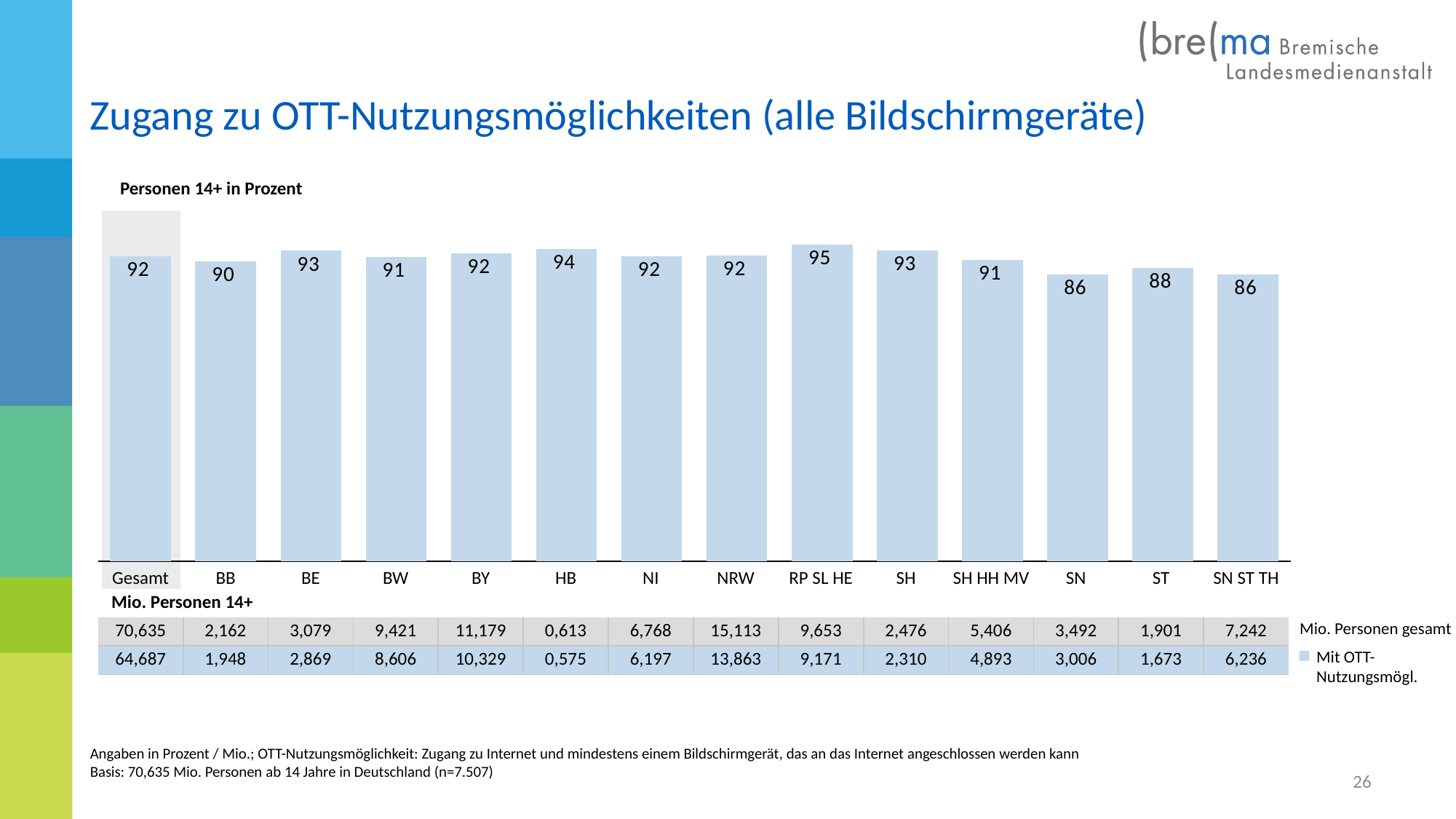
What is the difference between the values for BB and BE? 3 What is the value for SH HH MV in the chart? 91 What is the difference between the values for RP SL HE and SN? 9 Which is larger, the value for BE or the value for ST? BE Which category has the highest value in the chart? RP SL HE What kind of chart is shown on the slide? bar chart What is the value for HB in the chart? 94 How many categories are shown on the x axis of the chart? 14 What is the value for Gesamt in the chart? 92 According to the table below the chart, how many Mio. Personen with OTT-Nutzungsmögl. are listed for Gesamt? 64,687 What is the title of the slide containing the chart? Zugang zu OTT-Nutzungsmöglichkeiten (alle Bildschirmgeräte) According to the table below the chart, how many Mio. Personen gesamt are listed for NRW? 15,113